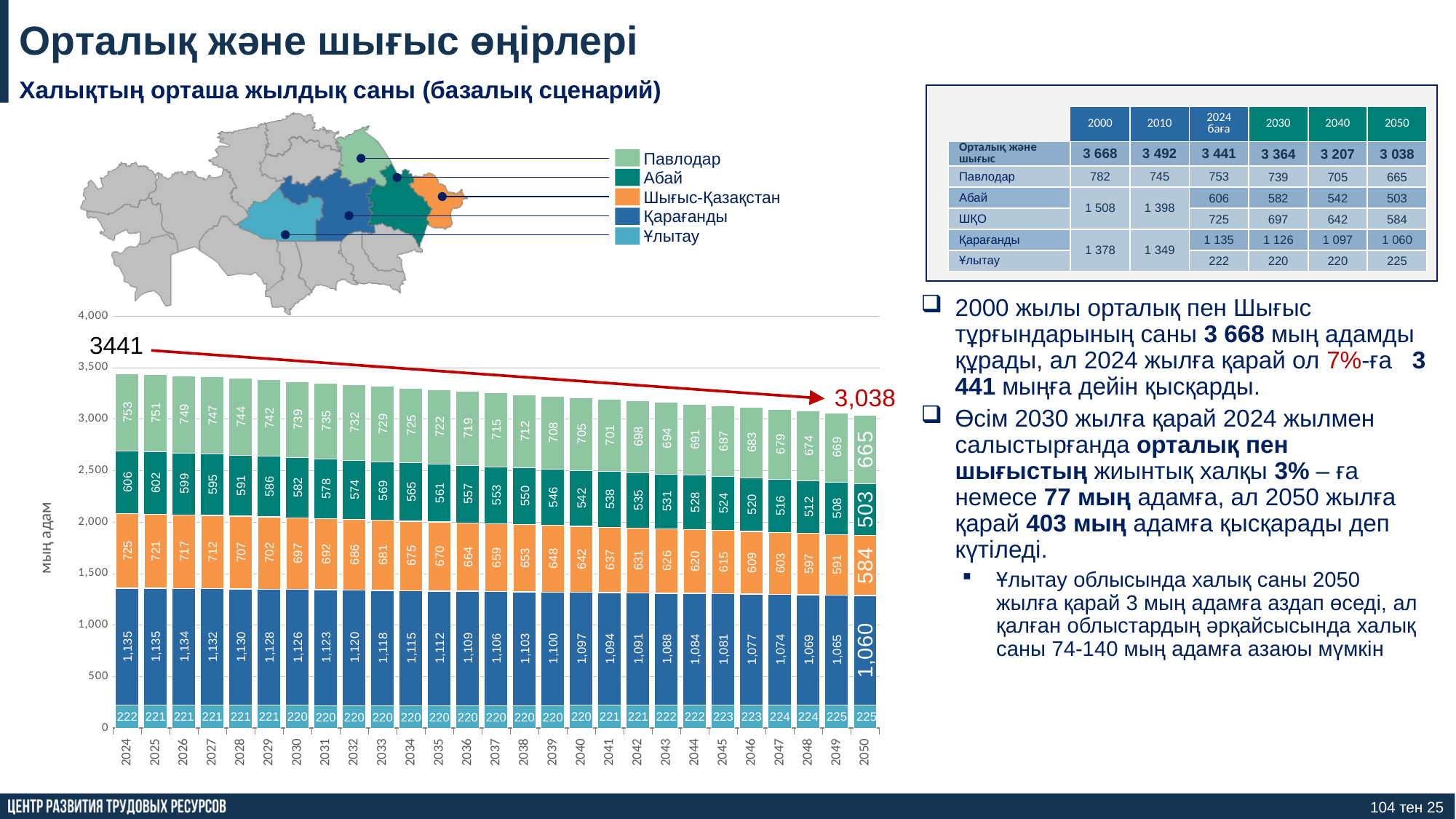
Which region has the largest value in 2024? Қарағанды What is the value for Шығыс-Қазақстан in 2040? 642 What is the value for Ұлытау in 2030? 220 What kind of chart is shown on the slide? stacked bar chart How many regions (series) are stacked in each bar of the chart? 5 What is the value for Қарағанды in 2050? 1,060 What is the value for Павлодар in 2024? 753 Does the value for Павлодар rise or fall from 2024 to 2050? fall By how much does the value for Абай decrease from 2024 to 2050? 103 What is the total of the stacked bar for 2050, as annotated on the chart? 3,038 What is the value for Абай in 2035? 561 How many years (bars) are plotted on the x axis of the chart? 27